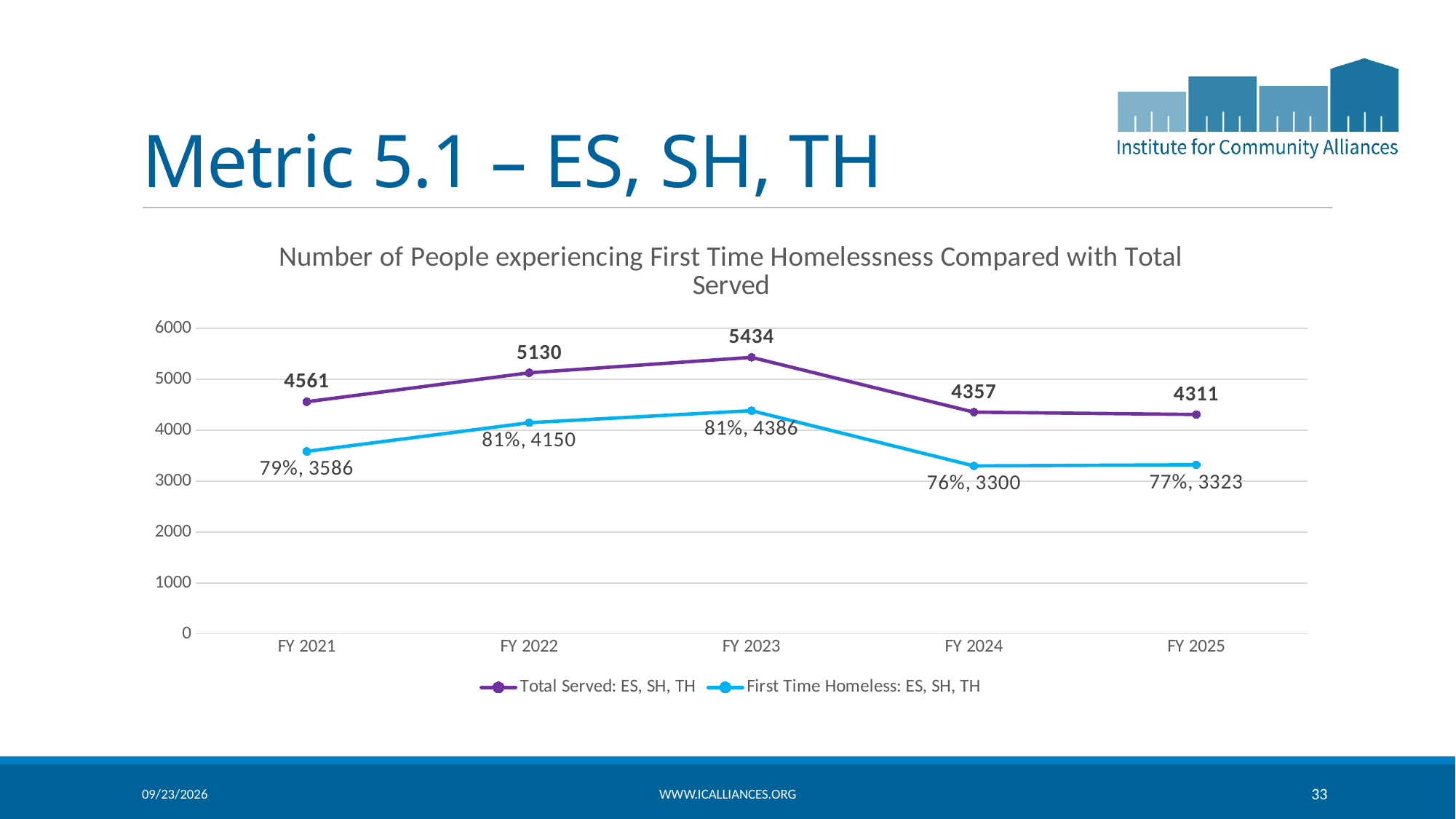
What is the First Time Homeless: ES, SH, TH value for FY 2021? 79%, 3586 How many series does the legend list? 2 Is the First Time Homeless value for FY 2023 greater or less than 4000? greater What percentage of Total Served were First Time Homeless in FY 2024? 76% What is the Total Served: ES, SH, TH value for FY 2023? 5434 In which fiscal year is Total Served: ES, SH, TH highest? FY 2023 What kind of chart is shown on the slide? line chart What is the difference between Total Served and First Time Homeless in FY 2022? 980 Which is larger: Total Served in FY 2021 or Total Served in FY 2024? FY 2021 How many fiscal years are shown on the x axis? 5 What is the Total Served: ES, SH, TH value for FY 2025? 4311 In which fiscal year is First Time Homeless: ES, SH, TH lowest? FY 2024